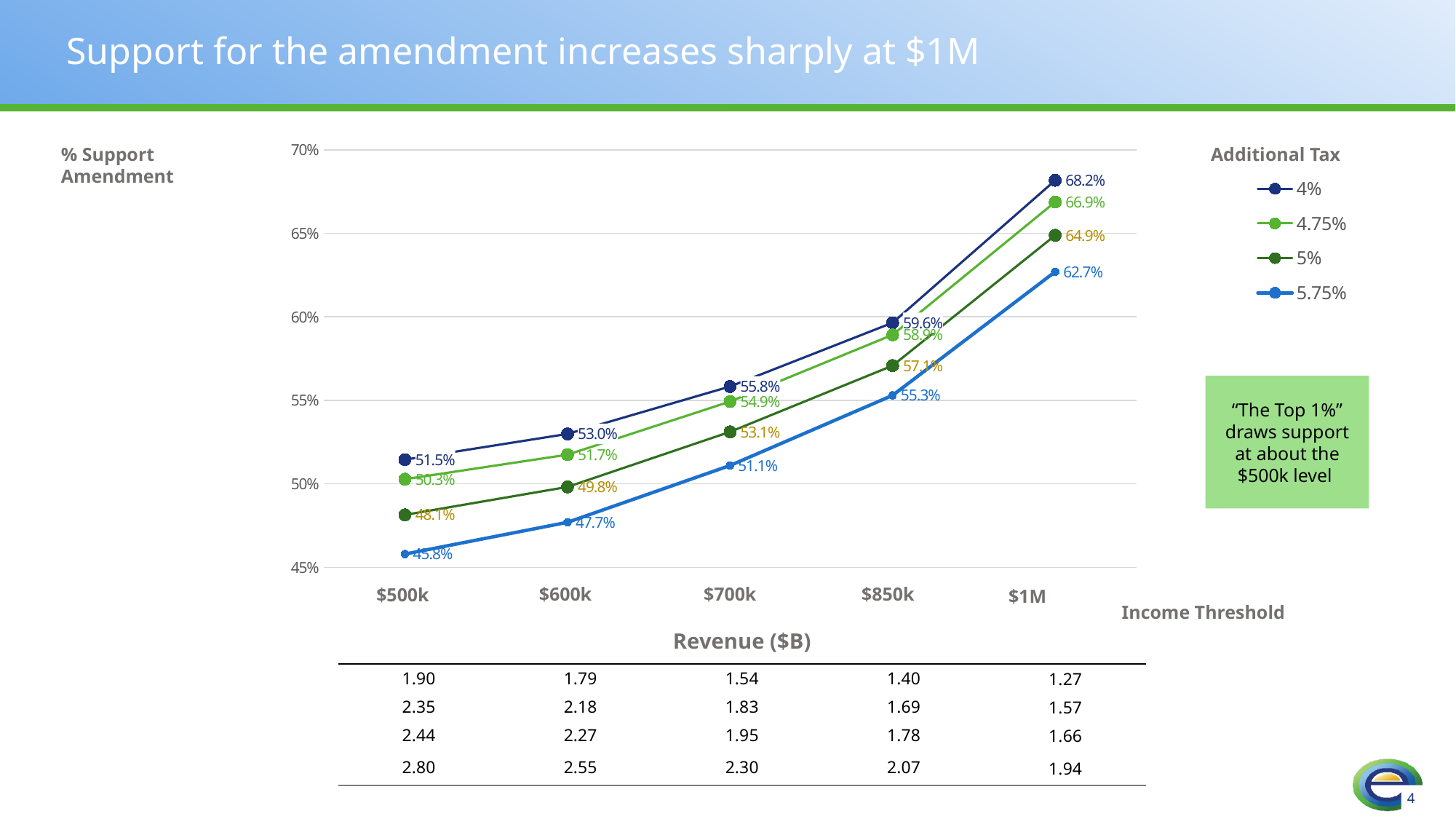
What is the % support for the 4% additional tax at the $1M income threshold? 68.2% What is the % support for the 5% additional tax at the $700k income threshold? 53.1% How many series does the legend list under "Additional Tax"? 4 What type of chart is shown on the slide? Line chart How many income threshold categories are plotted on the x axis? 5 Does support for each additional tax series rise or fall as the income threshold increases from $500k to $1M? Rise What is the difference in % support between the 4% and 5.75% additional tax series at the $1M threshold? 5.5 percentage points What is the % support for the 5.75% additional tax at the $500k income threshold? 45.8% At which income threshold is support for the 4% additional tax highest? $1M Which has higher support at the $600k threshold: the 4.75% additional tax or the 5% additional tax? 4.75% At which income threshold is support for the 5.75% additional tax lowest? $500k What is the % support for the 4.75% additional tax at the $850k income threshold? 58.9%